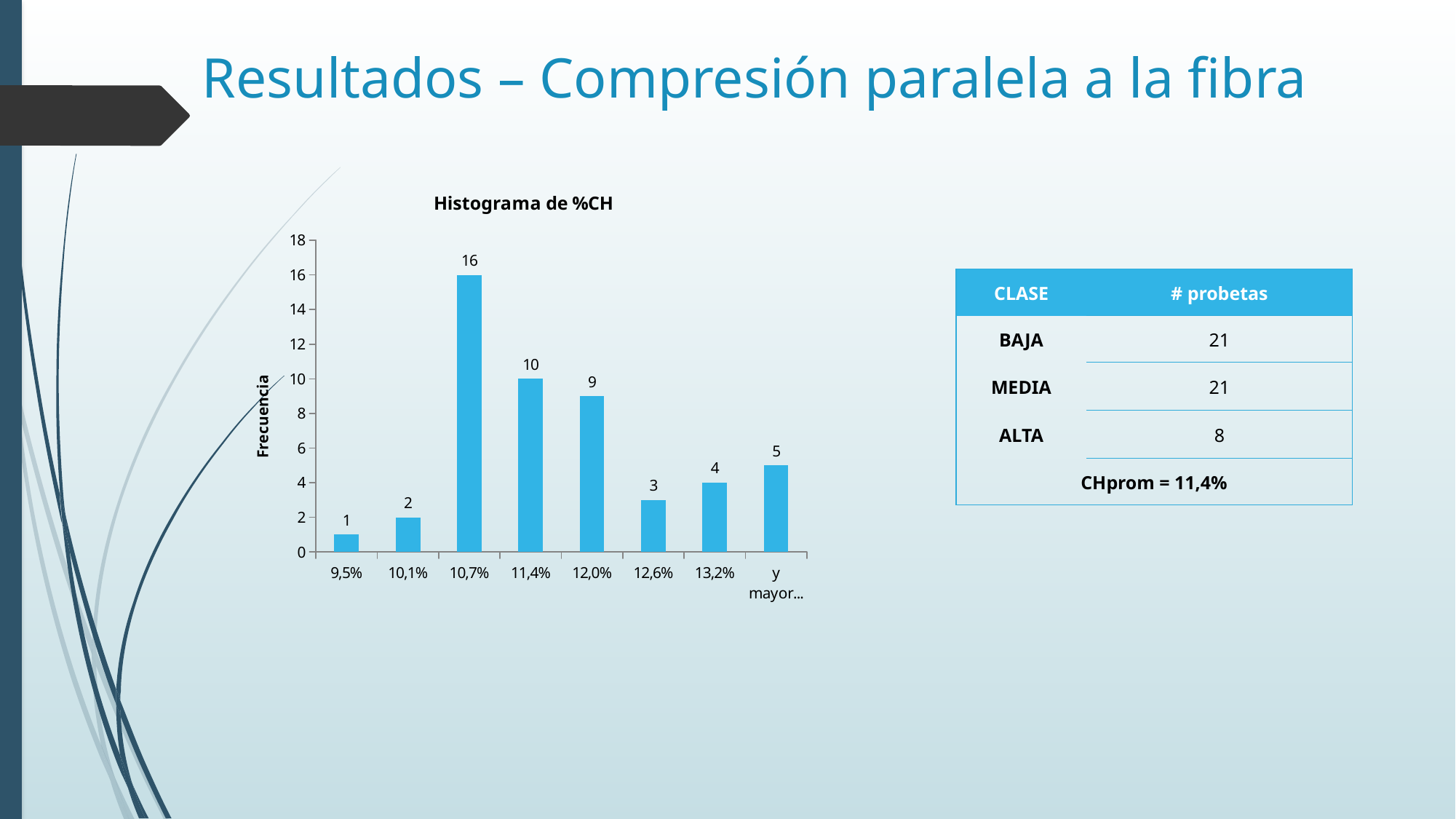
Which bin has the lowest frequency? 9,5% What is the frequency for the 9,5% bin? 1 Which bin has the highest frequency? 10,7% What kind of chart is shown on the slide? bar chart What is the difference in frequency between the 10,7% bin and the 11,4% bin? 6 What is the title of the chart? Histograma de %CH What is the frequency for the 10,7% bin in the histogram? 16 Which bin has a higher frequency, 13,2% or 12,6%? 13,2% How many bins are shown on the x axis of the histogram? 8 What is the frequency for the 12,0% bin? 9 Is the frequency for the 11,4% bin greater or less than 8? greater What is the label of the y axis? Frecuencia